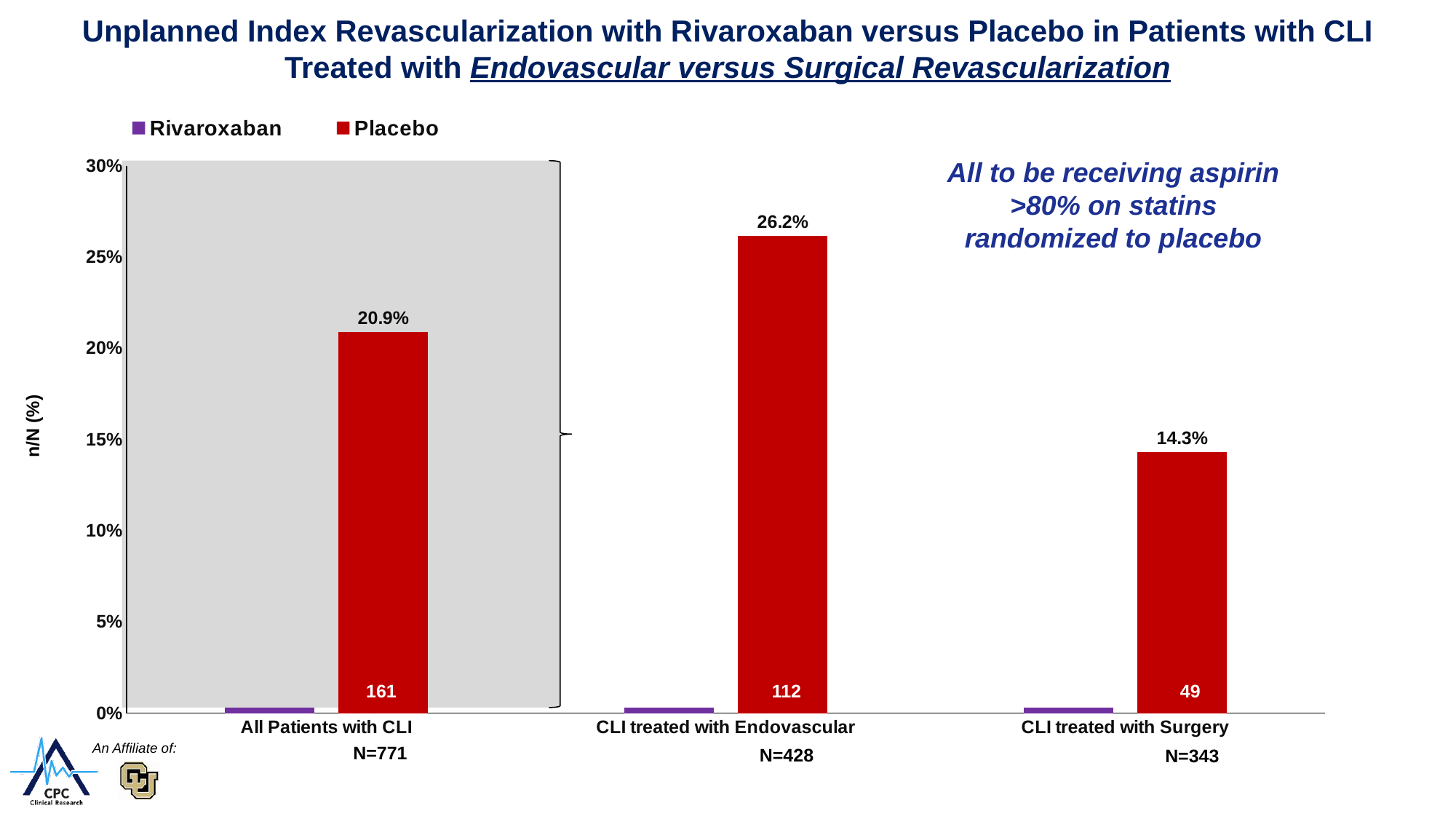
What is the number of events (n) shown inside the Placebo bar for CLI treated with Endovascular? 112 What is the Placebo value for CLI treated with Endovascular? 26.2% How many series does the legend list? 2 What is the Placebo value for All Patients with CLI? 20.9% What is the difference between the Placebo values for CLI treated with Endovascular and CLI treated with Surgery? 11.9% What is the Placebo value for CLI treated with Surgery? 14.3% Is the Placebo value for CLI treated with Endovascular greater or less than 25%? greater Which category has the lowest Placebo value? CLI treated with Surgery Which is larger, the Placebo value for All Patients with CLI or for CLI treated with Surgery? All Patients with CLI How many categories are shown on the x axis? 3 What kind of chart is shown on the slide? bar chart Which category has the highest Placebo value? CLI treated with Endovascular